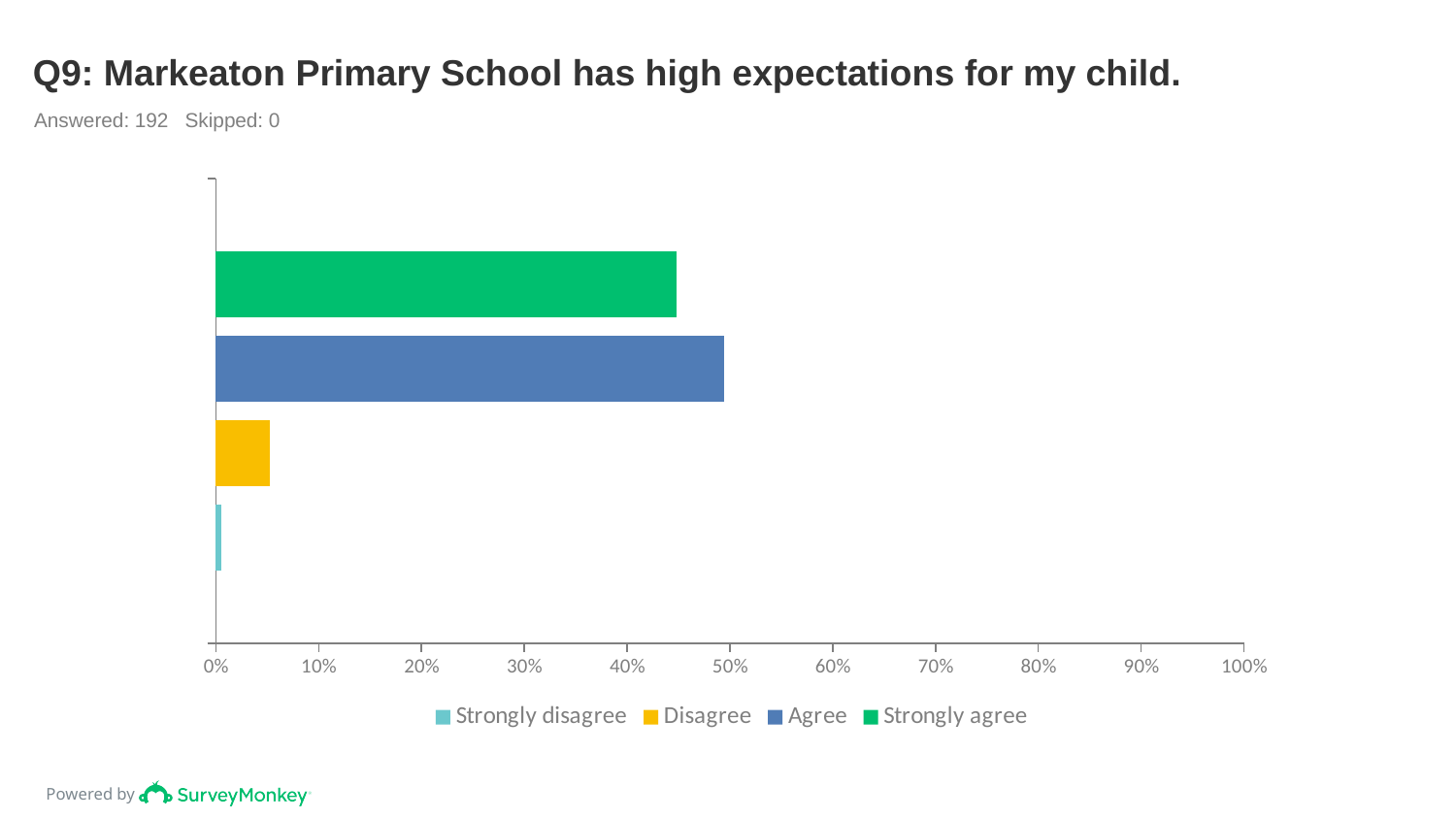
Which response option has the shortest bar? Strongly disagree Which is larger, the value for Agree or the value for Strongly agree? Agree Which response option has the longest bar? Agree What is the title of the chart? Q9: Markeaton Primary School has high expectations for my child. How many bars are plotted in the chart? 4 How many respondents answered the question according to the slide? 192 Is the value for Agree greater or less than 40%? greater Is the value for Disagree greater or less than 10%? less How many entries does the legend list? 4 Is the value for Strongly agree greater or less than 50%? less Which is larger, the value for Disagree or the value for Strongly disagree? Disagree What kind of chart is shown on the slide? bar chart